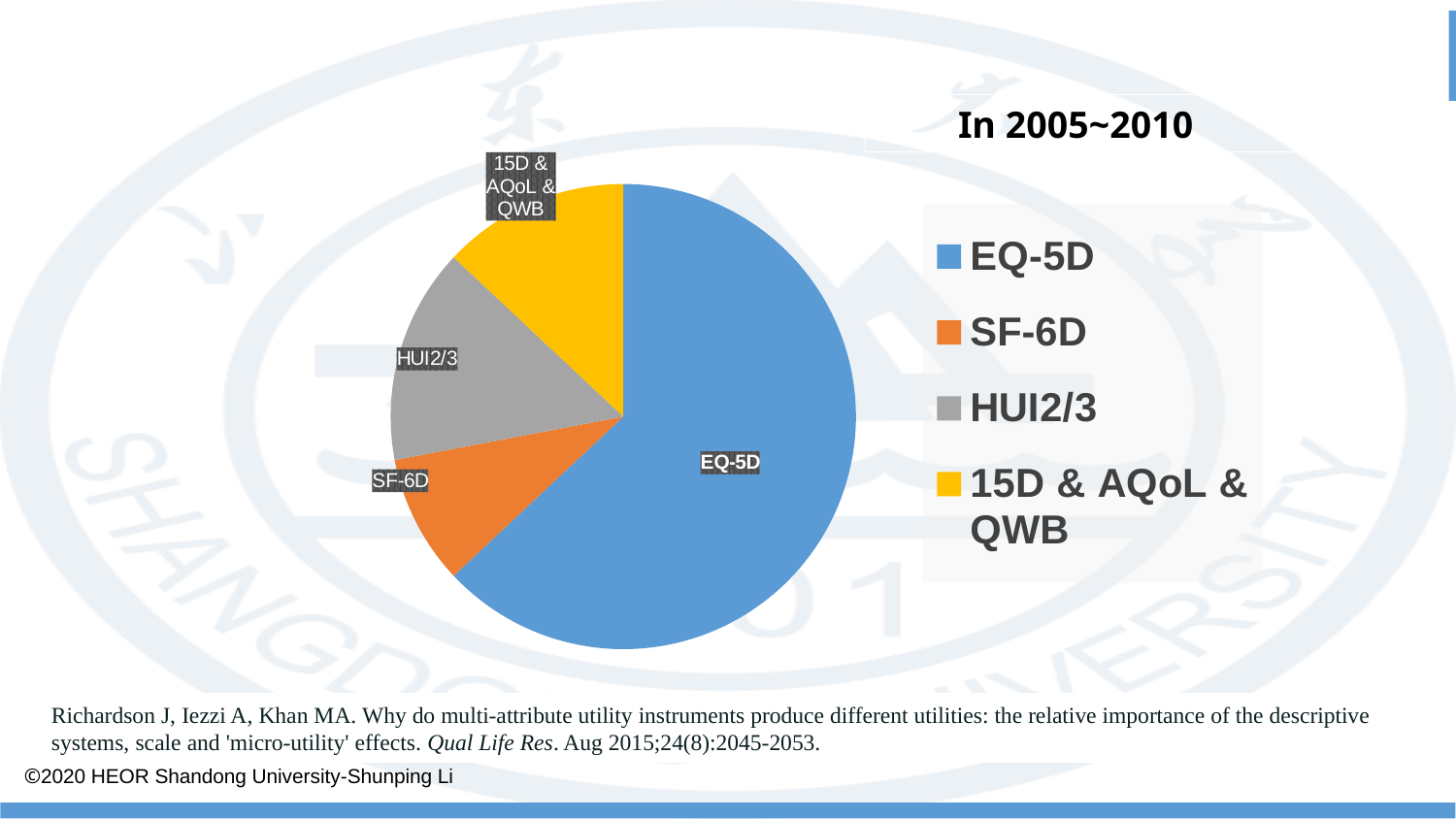
What time period does the title of the pie chart refer to? In 2005~2010 Which slice is larger, SF-6D or HUI2/3? HUI2/3 What kind of chart is shown on the slide? pie chart How many slices does the pie chart have? 4 How many entries does the legend of the pie chart list? 4 Which slice is larger, EQ-5D or HUI2/3? EQ-5D Which instrument has the smallest slice in the pie chart? SF-6D Which instrument has the largest slice in the pie chart? EQ-5D What colour is the EQ-5D slice in the pie chart? blue Which slice is larger, SF-6D or EQ-5D? EQ-5D Is the share of the pie for EQ-5D greater or less than 50%? greater